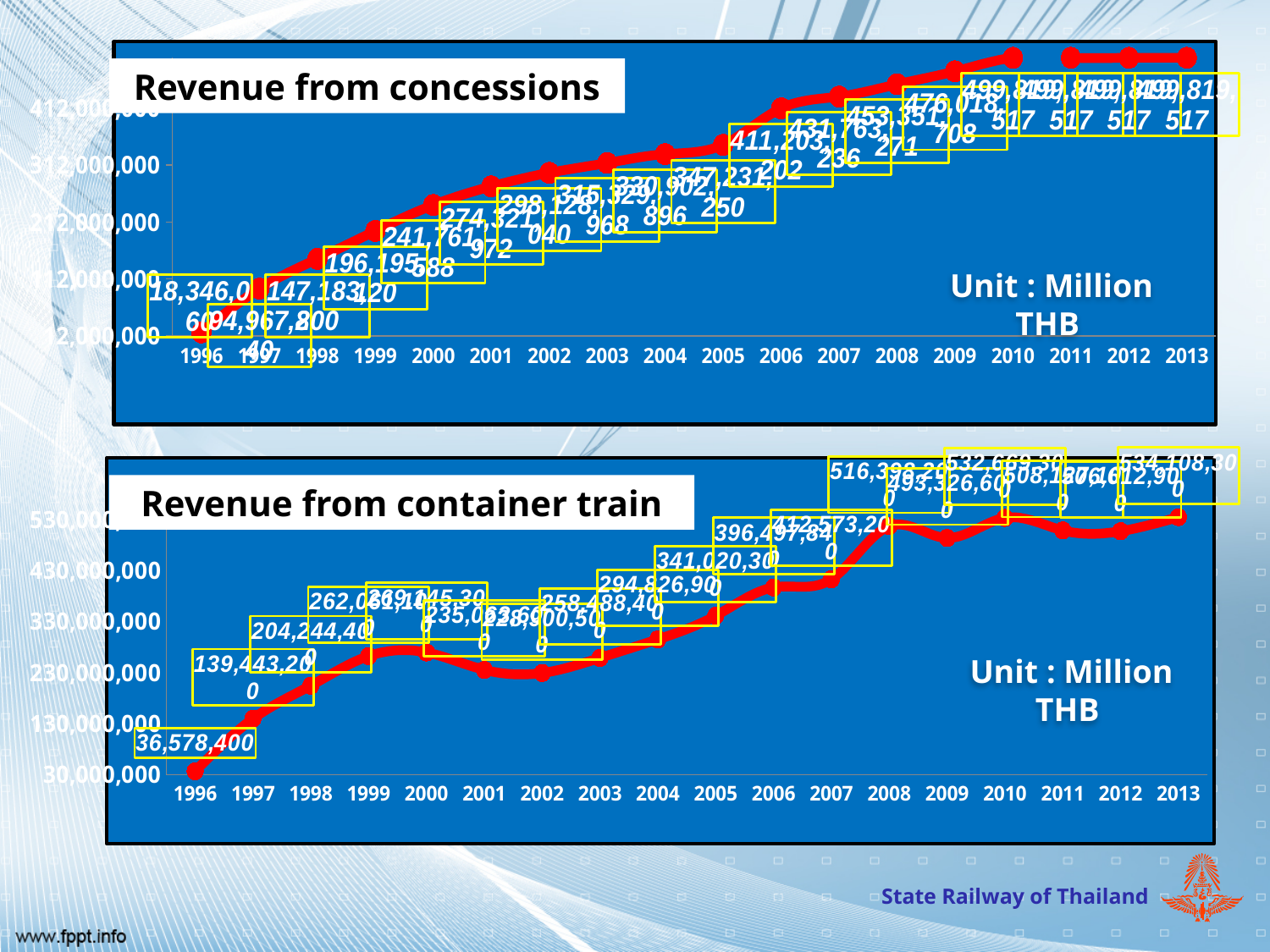
What kind of chart is the 'Revenue from container train' chart? line chart How many years are plotted on the x axis of the 'Revenue from container train' chart? 18 In the 'Revenue from container train' chart, which year has the lowest value? 1996 How many years are plotted on the x axis of the 'Revenue from concessions' chart? 18 What unit is stated on the 'Revenue from container train' chart? Million THB In the 'Revenue from container train' chart, which is larger, the value for 2005 or the value for 2002? 2005 In the 'Revenue from concessions' chart, is the value for 2013 greater or less than 412,000,000? greater In the 'Revenue from concessions' chart, do the values generally rise or fall from 1996 to 2013? rise In the 'Revenue from concessions' chart, which year has the lowest value? 1996 In the 'Revenue from container train' chart, what is the value for 1996? 36,578,400 In the 'Revenue from container train' chart, is the value for 2006 greater or less than 330,000,000? greater What kind of chart is the 'Revenue from concessions' chart? line chart